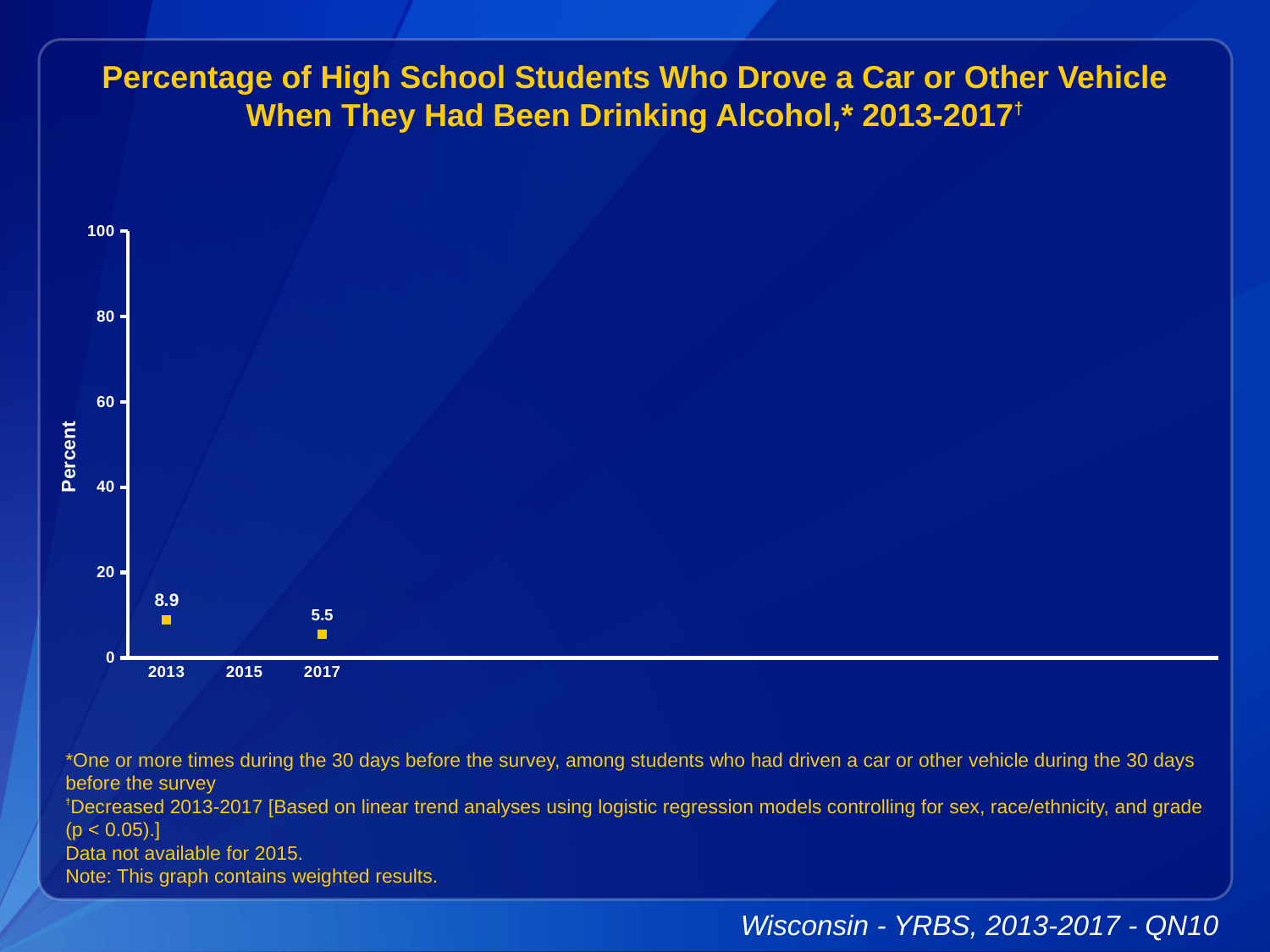
Is the value for 2013 greater or less than 20? less What is the maximum value shown on the y axis? 100 Do the values rise or fall from 2013 to 2017? fall Which year has the lowest plotted value? 2017 Which is larger, the value for 2013 or the value for 2017? 2013 Which year on the x axis has no data plotted? 2015 What is the value for 2013? 8.9 What is the value for 2017? 5.5 Which year has the highest value? 2013 What is the difference between the 2013 and 2017 values? 3.4 How many data points are plotted on the chart? 2 What is the label on the y axis? Percent